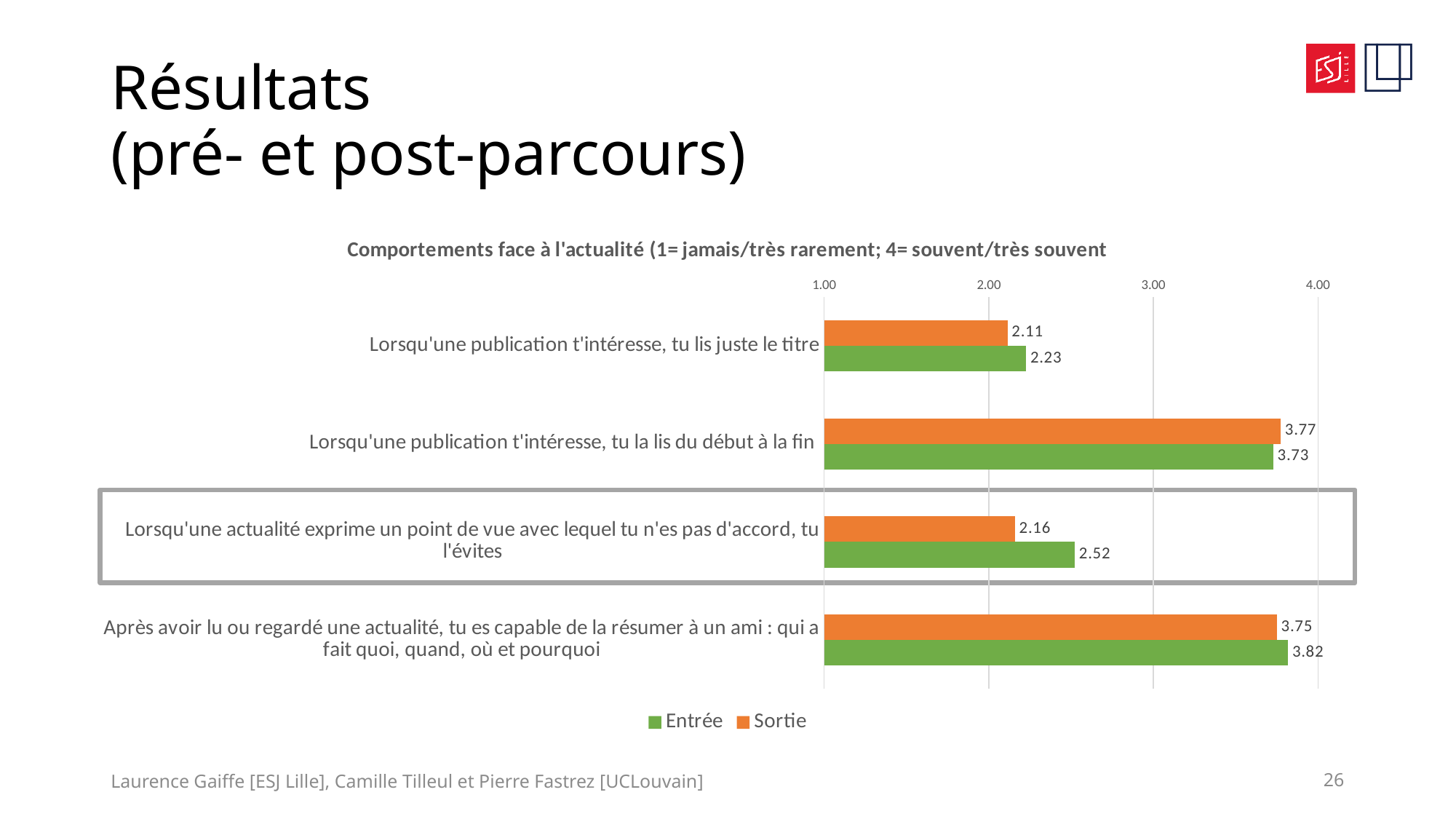
Which category has the highest Entrée value? Après avoir lu ou regardé une actualité, tu es capable de la résumer à un ami : qui a fait quoi, quand, où et pourquoi What is the Entrée value for "Lorsqu'une publication t'intéresse, tu la lis du début à la fin"? 3.73 For "Lorsqu'une publication t'intéresse, tu lis juste le titre", which is larger, the Entrée value or the Sortie value? Entrée How many categories are shown on the chart? 4 How many series does the legend list? 2 Is the Sortie value for "Lorsqu'une publication t'intéresse, tu la lis du début à la fin" greater or less than 3.00? greater What kind of chart is shown on the slide? Bar chart Which category has the lowest Sortie value? Lorsqu'une publication t'intéresse, tu lis juste le titre What is the Sortie value for "Après avoir lu ou regardé une actualité, tu es capable de la résumer à un ami : qui a fait quoi, quand, où et pourquoi"? 3.75 What is the difference between the Entrée and Sortie values for "Lorsqu'une actualité exprime un point de vue avec lequel tu n'es pas d'accord, tu l'évites"? 0.36 What is the Entrée value for "Lorsqu'une actualité exprime un point de vue avec lequel tu n'es pas d'accord, tu l'évites"? 2.52 What is the Sortie value for "Lorsqu'une publication t'intéresse, tu lis juste le titre"? 2.11